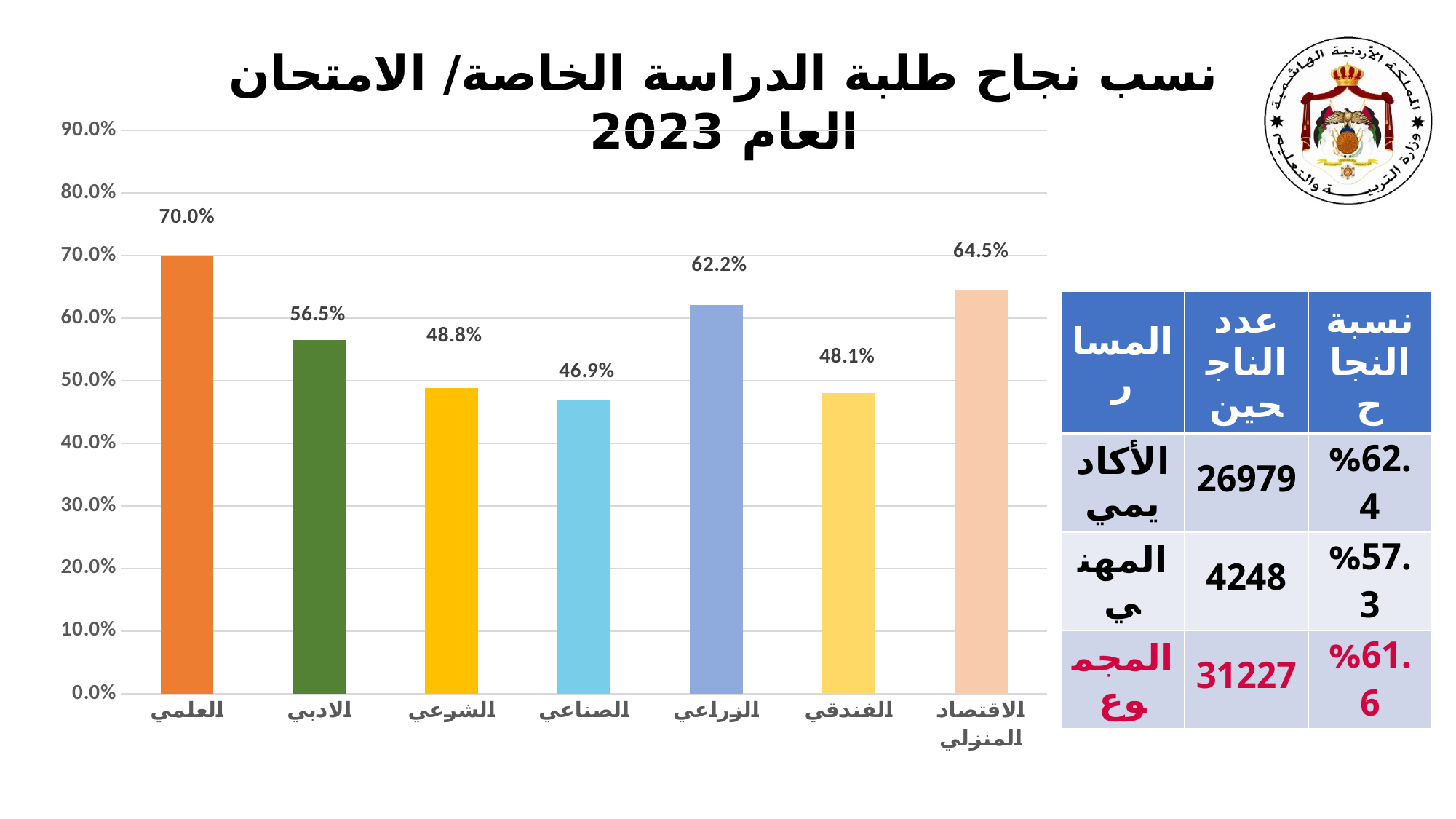
What is the difference between the values for العلمي and الادبي? 13.5% What is the value for الاقتصاد المنزلي? 64.5% How many categories are shown in the chart? 7 Which category has the lowest value? الصناعي Which category has the highest value? العلمي Is the value for الشرعي greater or less than 50.0%? less What is the value for العلمي? 70.0% Which is larger, the value for الزراعي or the value for الاقتصاد المنزلي? الاقتصاد المنزلي What is the value for الزراعي? 62.2% What kind of chart is shown on the slide? bar chart What is the title of the chart? نسب نجاح طلبة الدراسة الخاصة/ الامتحان العام 2023 What is the value for الصناعي? 46.9%